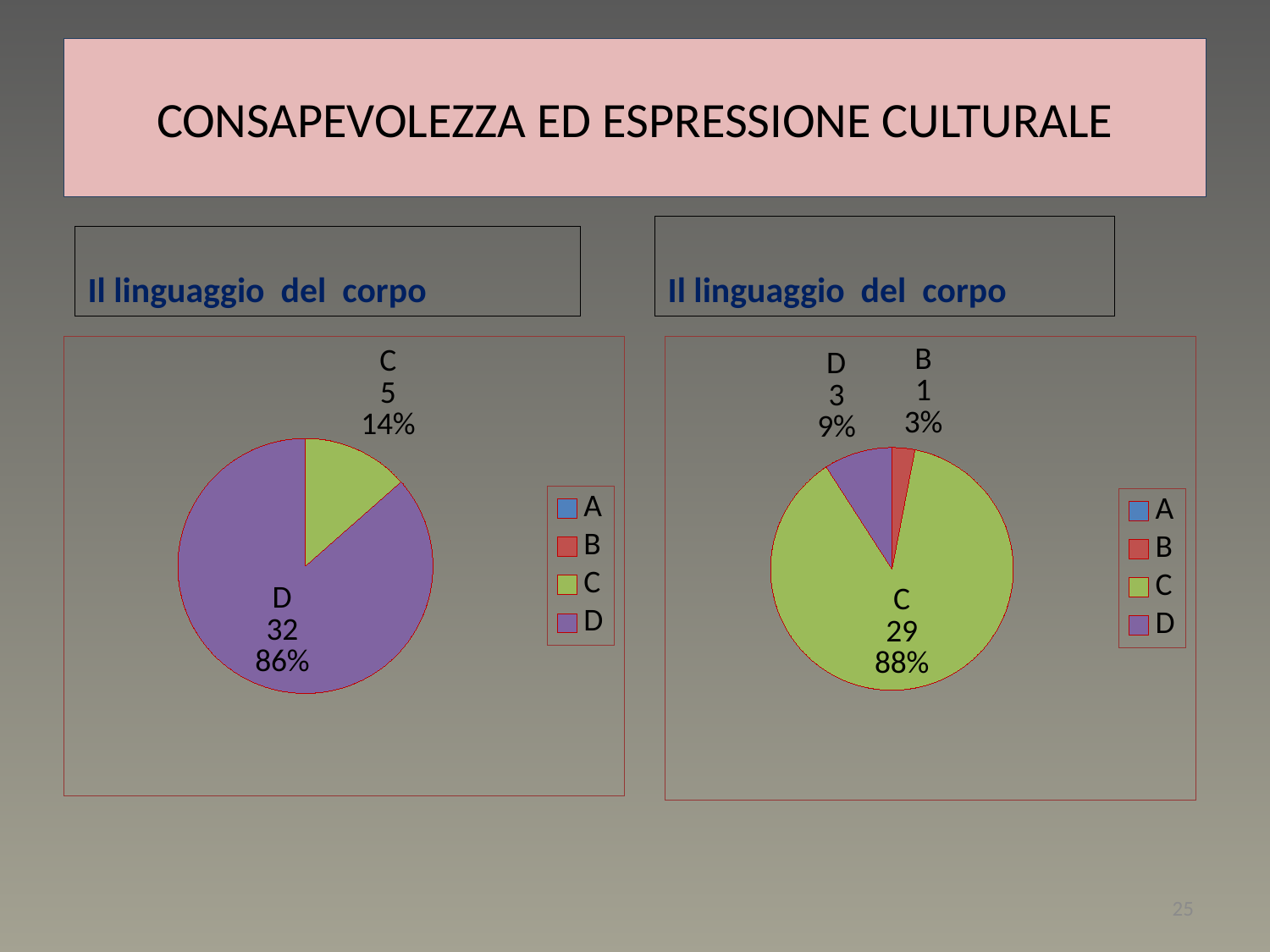
How many entries does the legend of the left chart list? 4 In the left pie chart, which category has the largest slice? D In the right pie chart, what percentage share does category D have? 9% What kind of chart is the left chart on the slide? pie chart In the left pie chart, what percentage share does category C have? 14% In the right pie chart, what is the value for category C? 29 In the left pie chart, what is the difference between the values for D and C? 27 In the right pie chart, what is the difference between the values for C and D? 26 In the right pie chart, which labelled category has the smallest slice? B In the right pie chart, which is larger, the value for D or the value for B? D In the left pie chart, what is the value for category D? 32 What is the title shown above the right chart? Il linguaggio del corpo